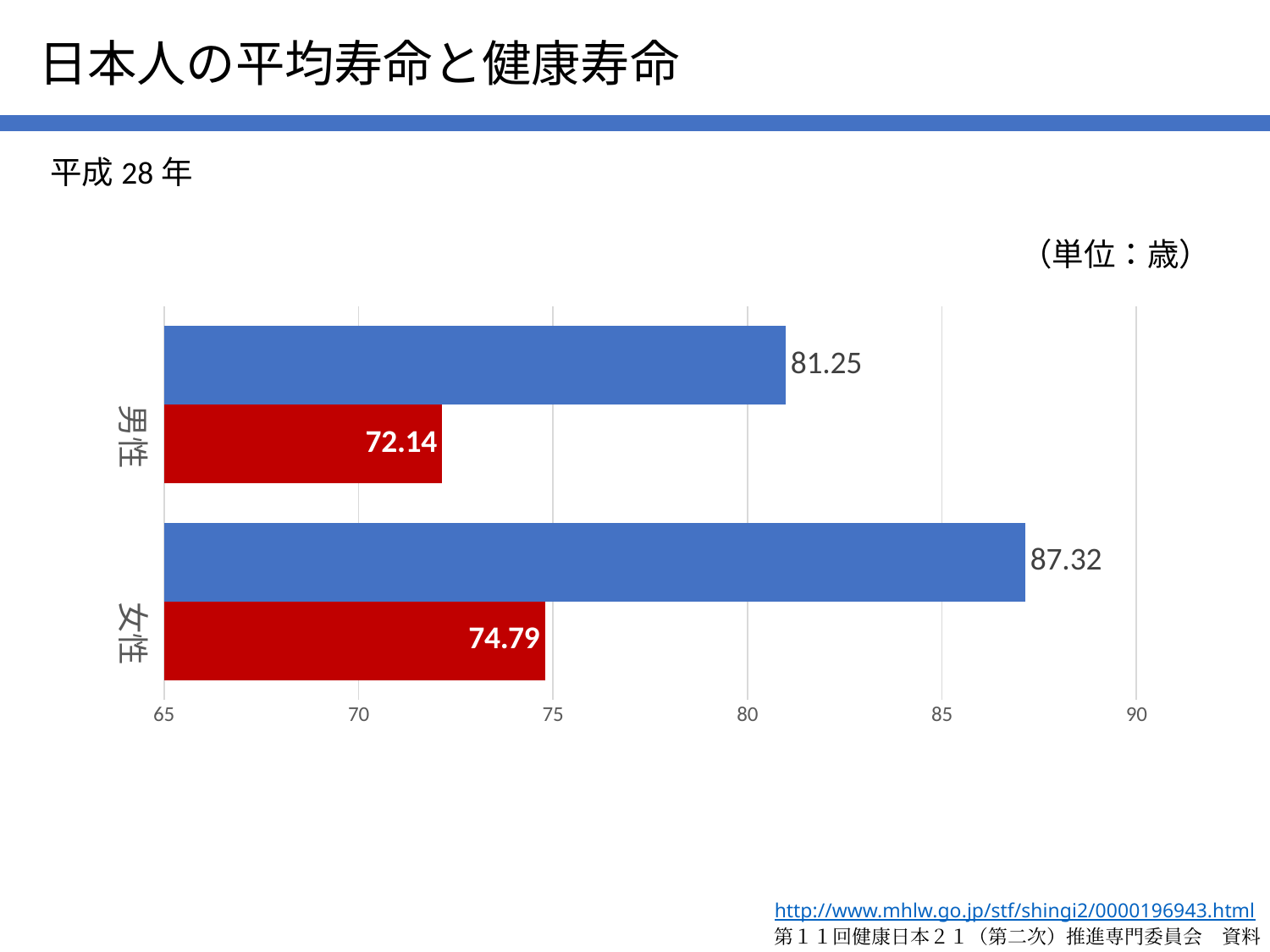
What is the value of the blue bar for 女性? 87.32 What is the value of the red bar for 男性? 72.14 What is the value of the red bar for 女性? 74.79 Which bar has the highest value on the chart? The blue bar for 女性 (87.32) What kind of chart is shown on the slide? Bar chart How many categories are shown on the chart? 2 Is the value of the red bar for 女性 greater or less than 75? less Which bar has the lowest value on the chart? The red bar for 男性 (72.14) What is the difference between the blue bar and the red bar for 男性? 9.11 What is the value of the blue bar for 男性? 81.25 What is the difference between the blue bar and the red bar for 女性? 12.53 Which is larger, the blue bar for 男性 or the blue bar for 女性? The blue bar for 女性